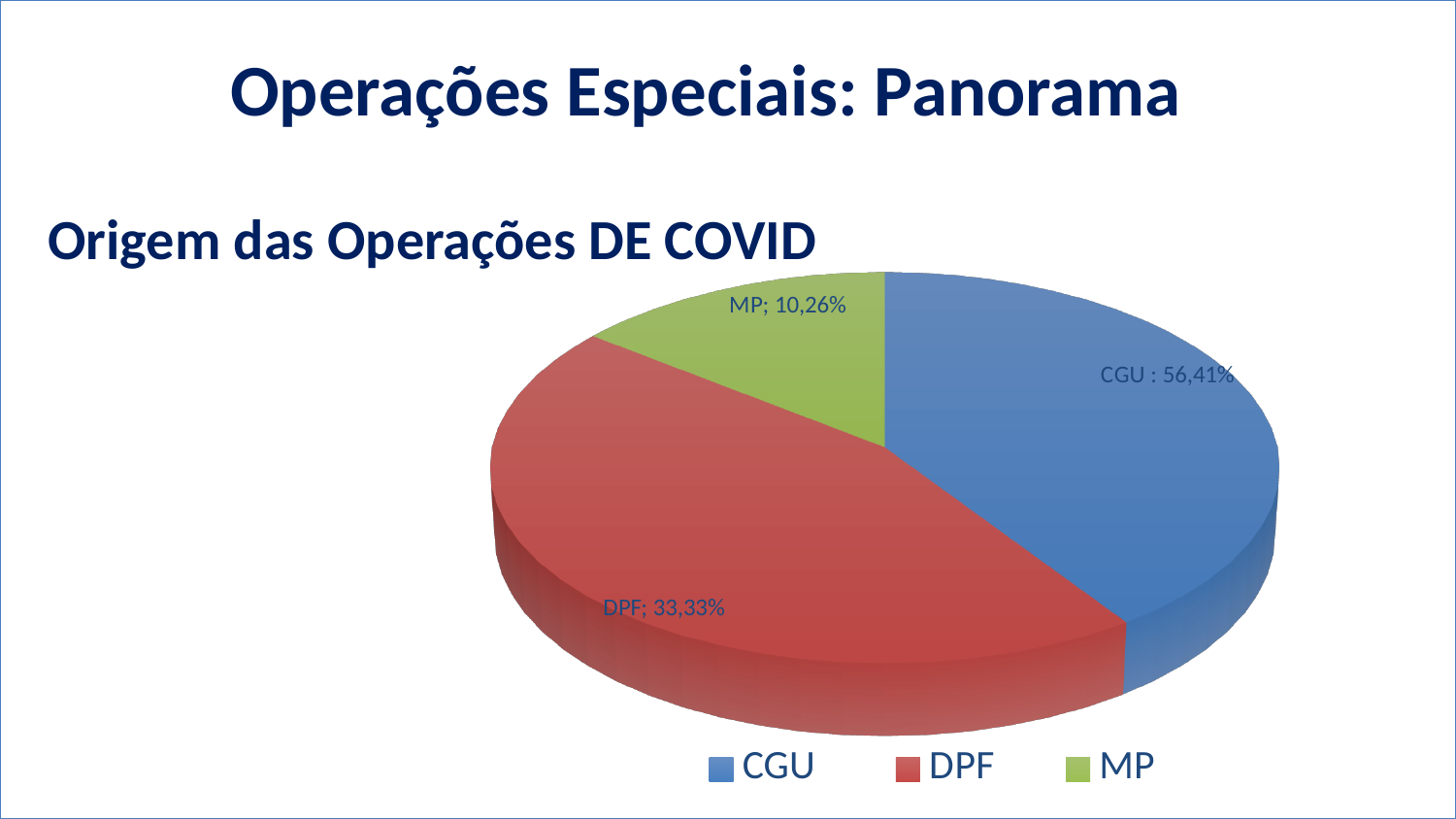
What share of the pie does CGU have? 56,41% What share of the pie does DPF have? 33,33% What colour is the DPF slice in the pie chart? red What is the heading shown above the pie chart? Origem das Operações DE COVID How many entries does the legend list? 3 Which category has the smallest slice of the pie? MP What kind of chart is shown on the slide? pie chart What is the difference in percentage points between the CGU share and the DPF share? 23,08 What share of the pie does MP have? 10,26% How many slices does the pie chart have? 3 Which is larger, the share for DPF or the share for MP? DPF Which category has the largest slice of the pie? CGU